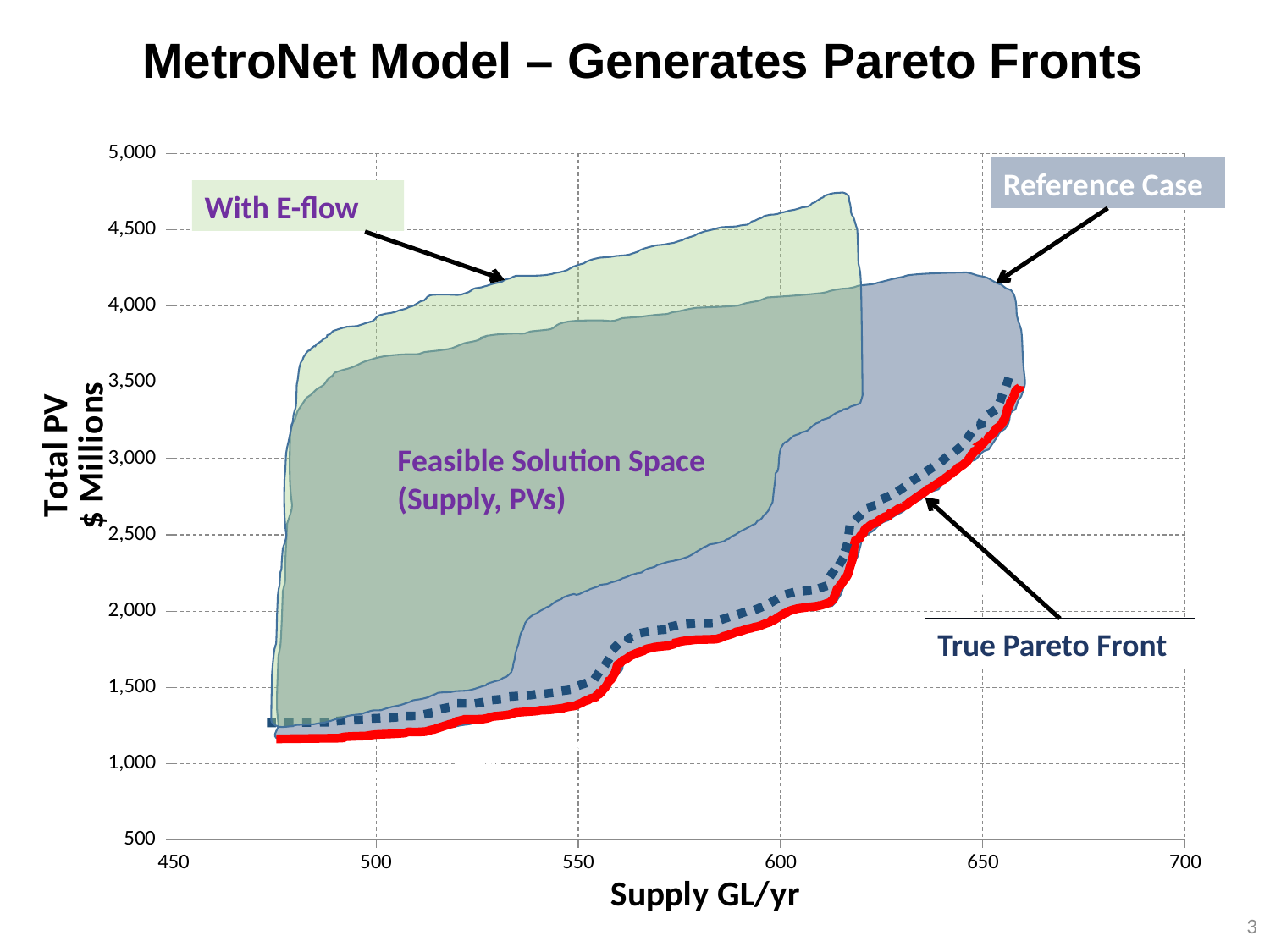
Is the True Pareto Front value at a supply of 500 GL/yr greater or less than 1,500? less What is the title of the y axis? Total PV $ Millions Is the True Pareto Front value at a supply of 550 GL/yr greater or less than 1,500? less Is the highest Total PV reached by the Reference Case region greater or less than 4,000? greater Which region extends to a higher Supply value, With E-flow or Reference Case? Reference Case What kind of chart is shown on the slide? area chart What is the title of the x axis? Supply GL/yr Does the True Pareto Front rise or fall as Supply increases along the x axis? rise Which region reaches a higher Total PV, With E-flow or Reference Case? With E-flow